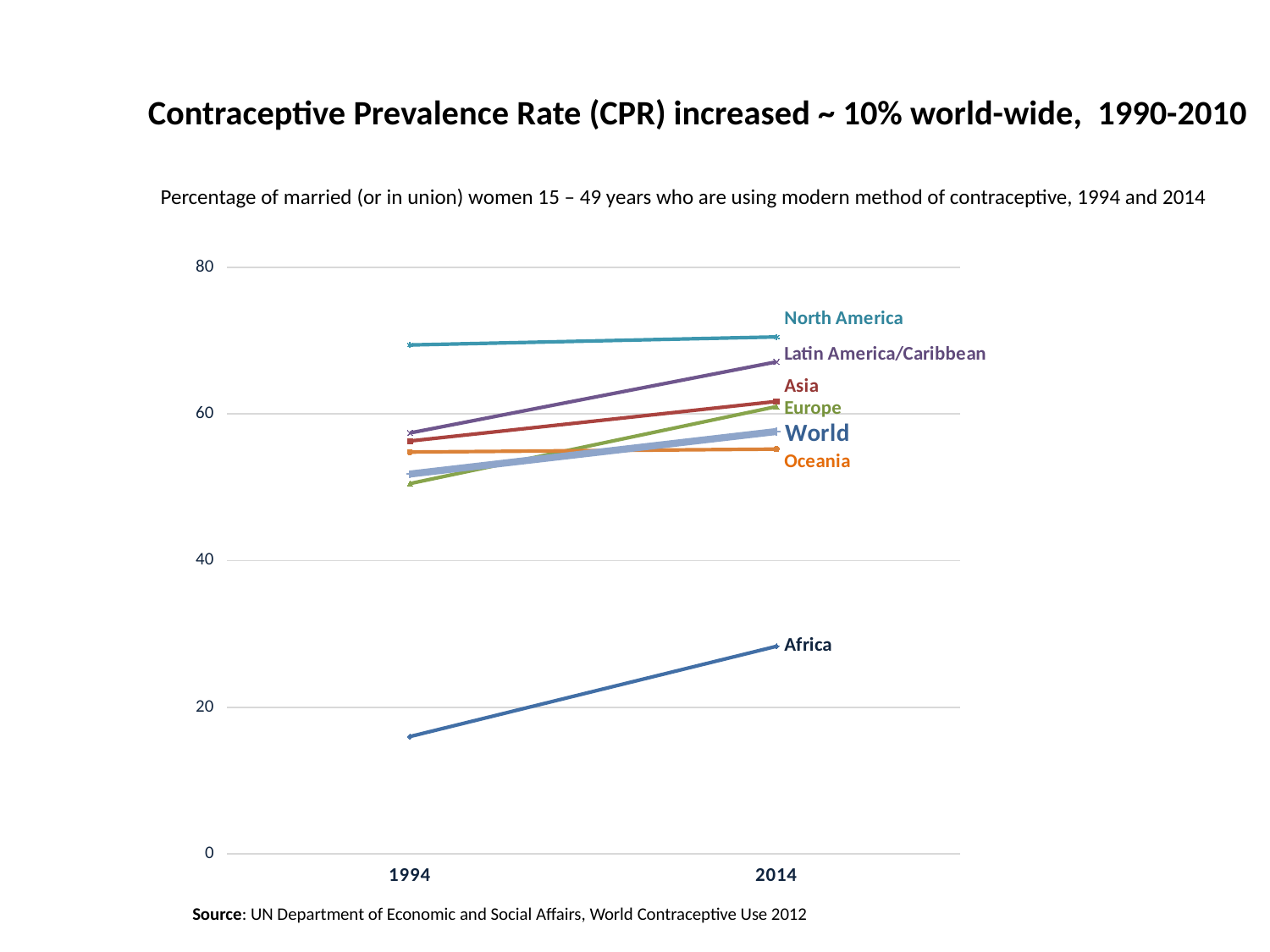
How many series (regions) are plotted on the chart? 7 Which region has the lowest value in 1994? Africa What kind of chart is shown on the slide? line chart Is the value for Africa in 2014 greater or less than 20? greater Does the value for Africa rise or fall from 1994 to 2014? rise Is the value for Africa in 1994 greater or less than 20? less Is the value for North America in 2014 greater or less than 60? greater In 2014, which is larger: the value for Latin America/Caribbean or the value for Asia? Latin America/Caribbean Which region has the highest value in 2014? North America How many years are plotted along the x axis? 2 What is the source cited below the chart? UN Department of Economic and Social Affairs, World Contraceptive Use 2012